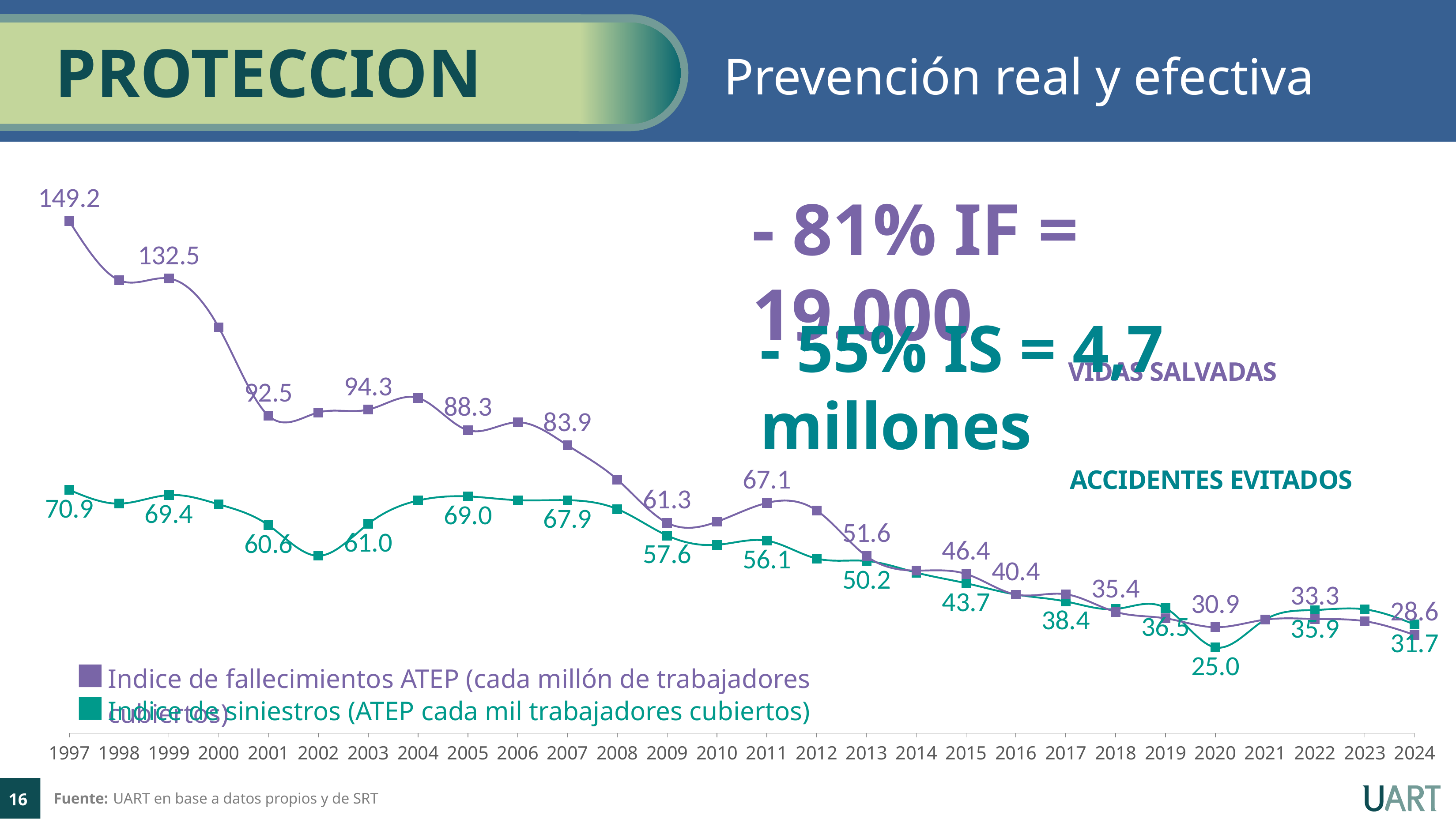
What is the value of the Indice de fallecimientos ATEP series in 2024? 28.6 What is the value of the Indice de siniestros series in 1997? 70.9 How many series does the chart legend list? 2 What kind of chart is shown on the slide? Line chart What is the value of the Indice de fallecimientos ATEP series in 1997? 149.2 What is the difference between the Indice de fallecimientos ATEP values in 1997 and 2024? 120.6 In which year is the Indice de fallecimientos ATEP series highest? 1997 How many years are shown along the x axis of the chart? 28 In which year does the Indice de siniestros series reach its lowest value, and what is that value? 2020, 25.0 Overall, do the values of the Indice de fallecimientos ATEP series rise or fall from 1997 to 2024? Fall What is the value of the Indice de siniestros series in 2024? 31.7 Which series has the larger value in 1997, Indice de fallecimientos ATEP or Indice de siniestros? Indice de fallecimientos ATEP